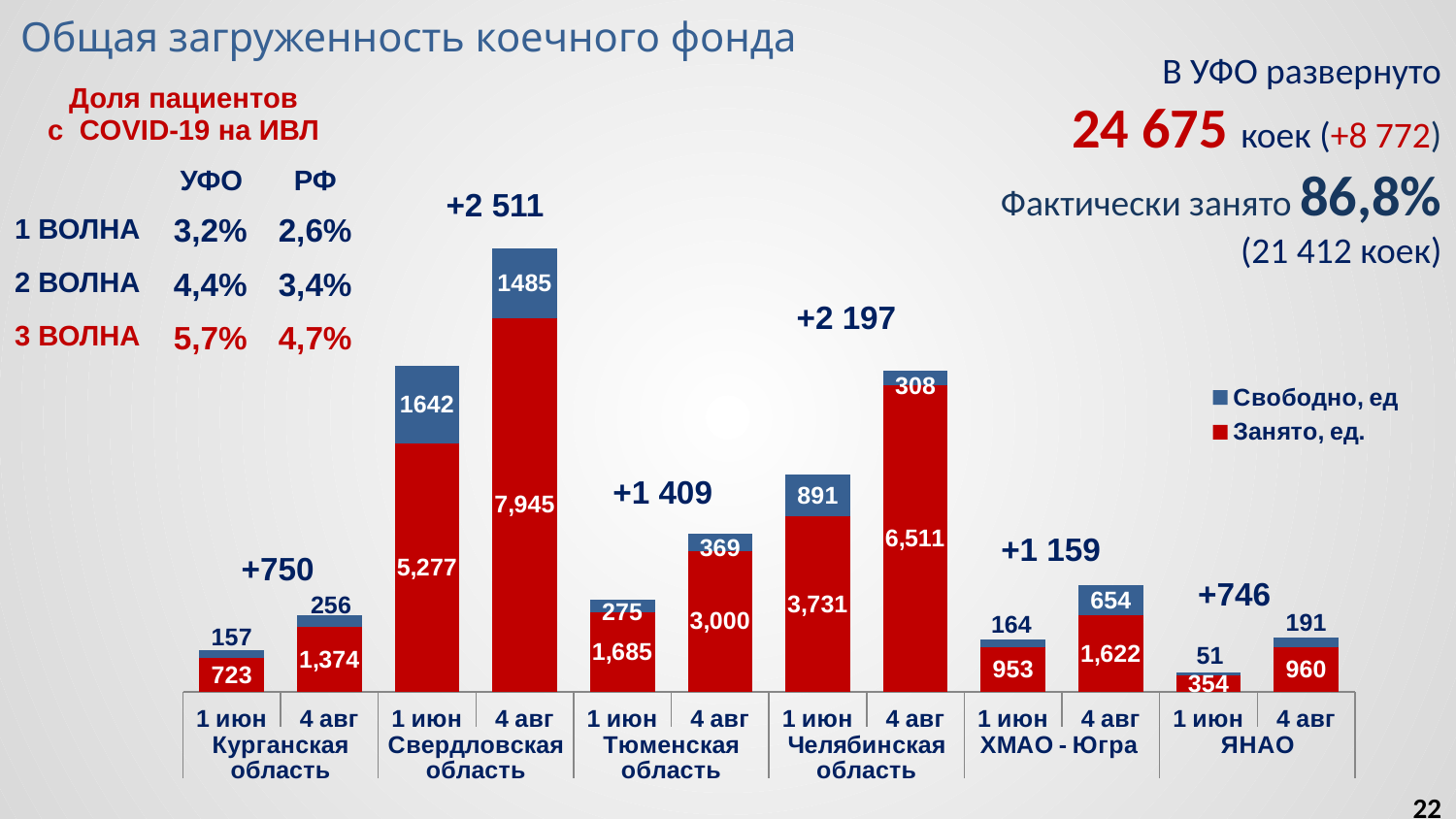
How many bars are plotted in the chart? 12 What is the value of Свободно, ед for Челябинская область on 1 июн? 891 How many series does the chart legend list? 2 Which is larger: Занято, ед. for ХМАО - Югра on 4 авг or for Курганская область on 4 авг? ХМАО - Югра on 4 авг What is the total height of the stacked bar for Свердловская область on 4 авг? 9,430 What kind of chart is shown on the slide? stacked bar chart What is the difference between the Занято, ед. values for Тюменская область on 4 авг and 1 июн? 1,315 What is the value of Занято, ед. for ЯНАО on 1 июн? 354 Which region has the lowest Свободно, ед value on 1 июн? ЯНАО Which region has the highest Занято, ед. value on 4 авг? Свердловская область What is the value of Занято, ед. for Свердловская область on 4 авг? 7,945 What are the two series named in the chart legend? Свободно, ед and Занято, ед.